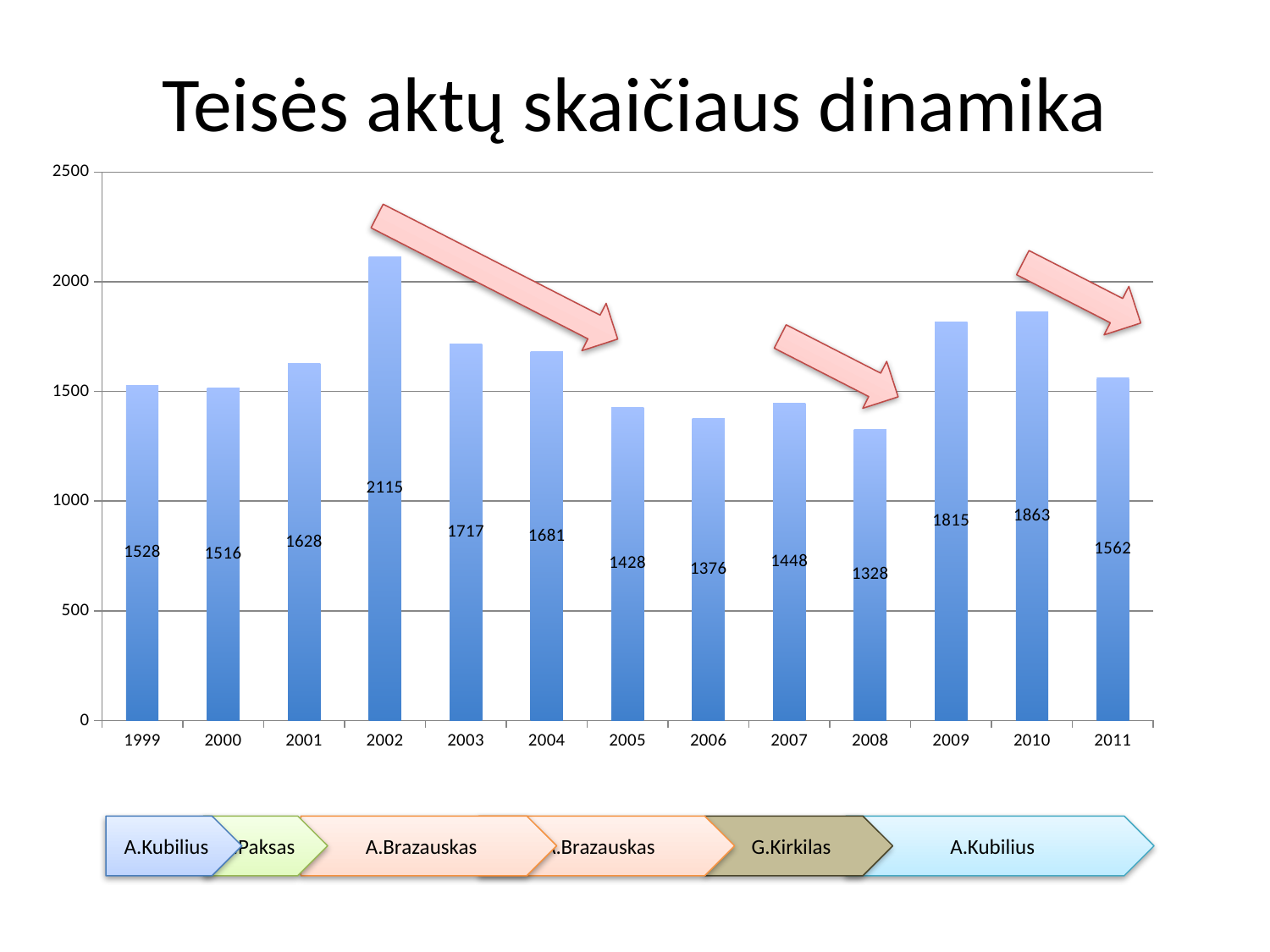
Is the value for 2006 greater or less than 1500? less What is the value for 2002? 2115 What is the difference between the values for 2010 and 2011? 301 What is the difference between the values for 2002 and 2003? 398 What is the title of the chart? Teisės aktų skaičiaus dinamika Which year has the highest value? 2002 Which year has the lowest value? 2008 How many years are shown on the x axis? 13 What is the value for 2011? 1562 Which is larger, the value for 2009 or the value for 2010? 2010 What kind of chart is shown on the slide? bar chart What is the value for 2008? 1328